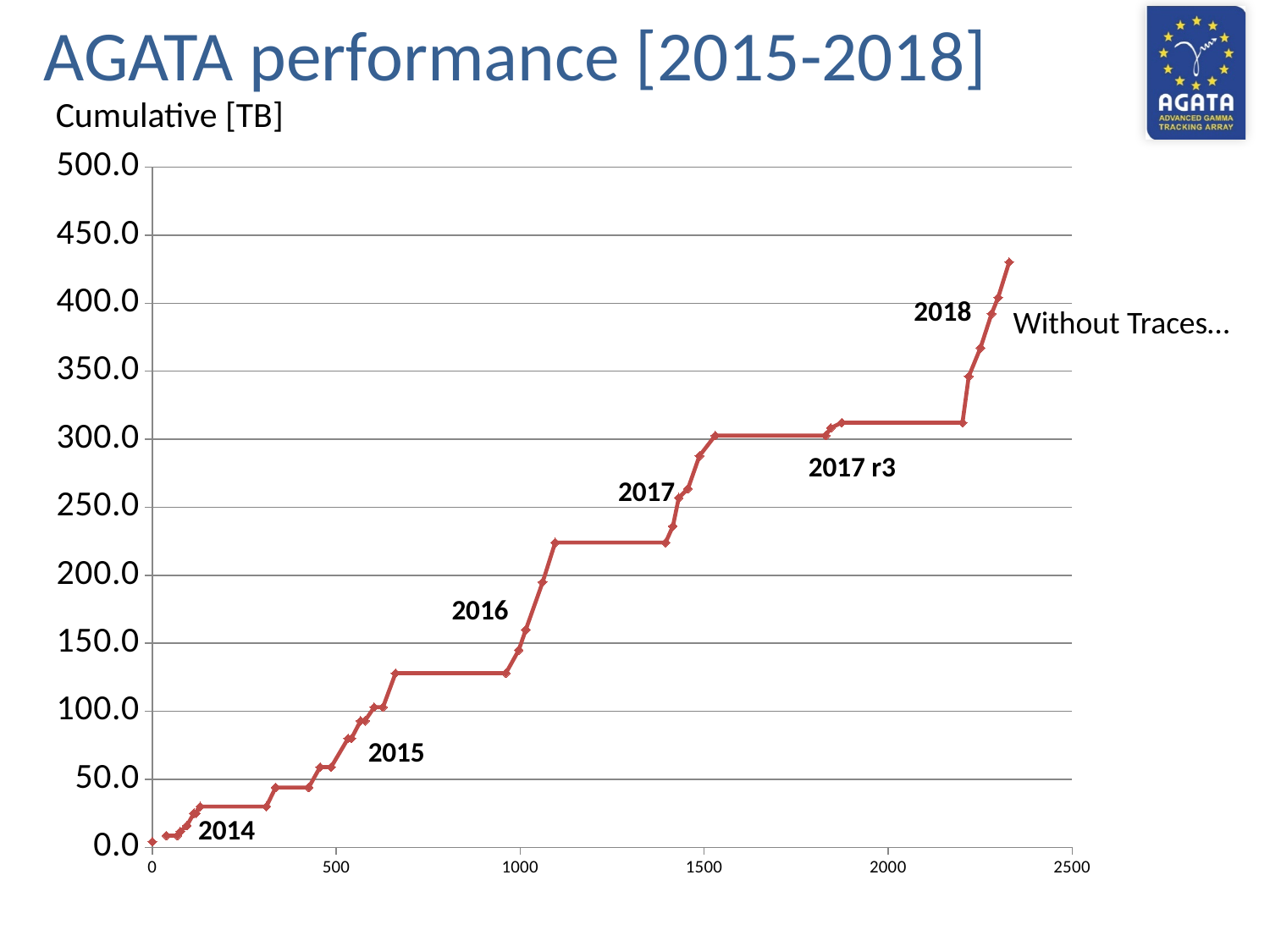
Is the value of the plateau labelled 2017 r3 greater or less than 350? less Is the value of the plateau following the 2016 rise greater or less than 250? less Is the final (rightmost) value of the line greater or less than 450? less Do the plotted values rise or fall as the x axis increases? rise What kind of chart is shown on the slide? line chart What is the highest tick value shown on the vertical axis? 500.0 What is the label of the vertical axis of the chart? Cumulative [TB]